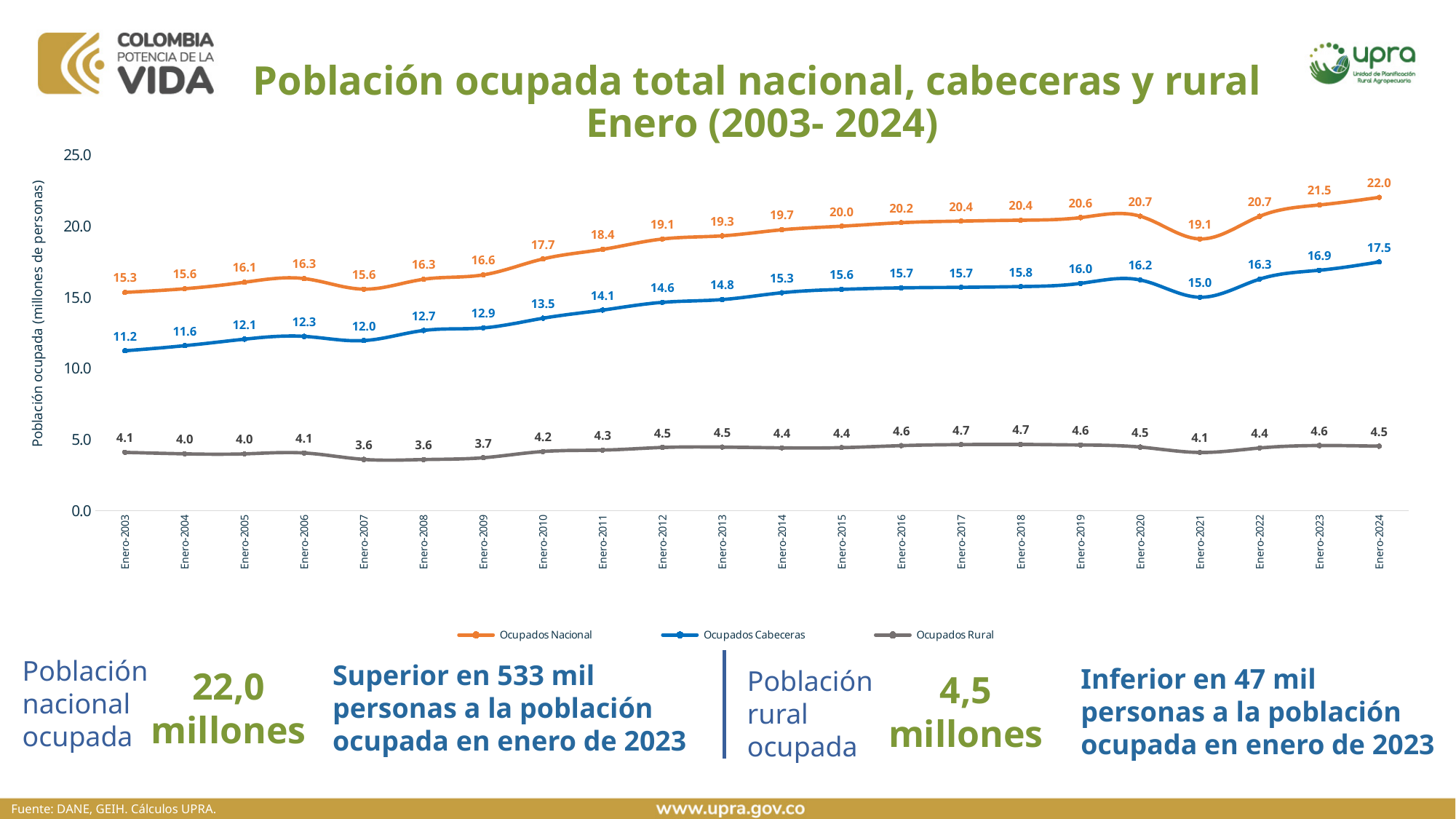
In which period does the Ocupados Nacional series reach its highest value? Enero-2024 What is the difference between the Ocupados Nacional values for Enero-2024 and Enero-2023? 0.5 How many time points are plotted for each series? 22 How many series does the legend list? 3 What is the difference between Ocupados Nacional and Ocupados Cabeceras in Enero-2024? 4.5 What is the value of Ocupados Nacional in Enero-2024? 22.0 Does the Ocupados Cabeceras series generally rise or fall from Enero-2003 to Enero-2024? rise What is the value of Ocupados Rural in Enero-2021? 4.1 In which period does the Ocupados Cabeceras series have its lowest value? Enero-2003 Which is larger for Ocupados Rural: the value in Enero-2017 or in Enero-2021? Enero-2017 What is the value of Ocupados Cabeceras in Enero-2003? 11.2 What kind of chart is shown on the slide? line chart